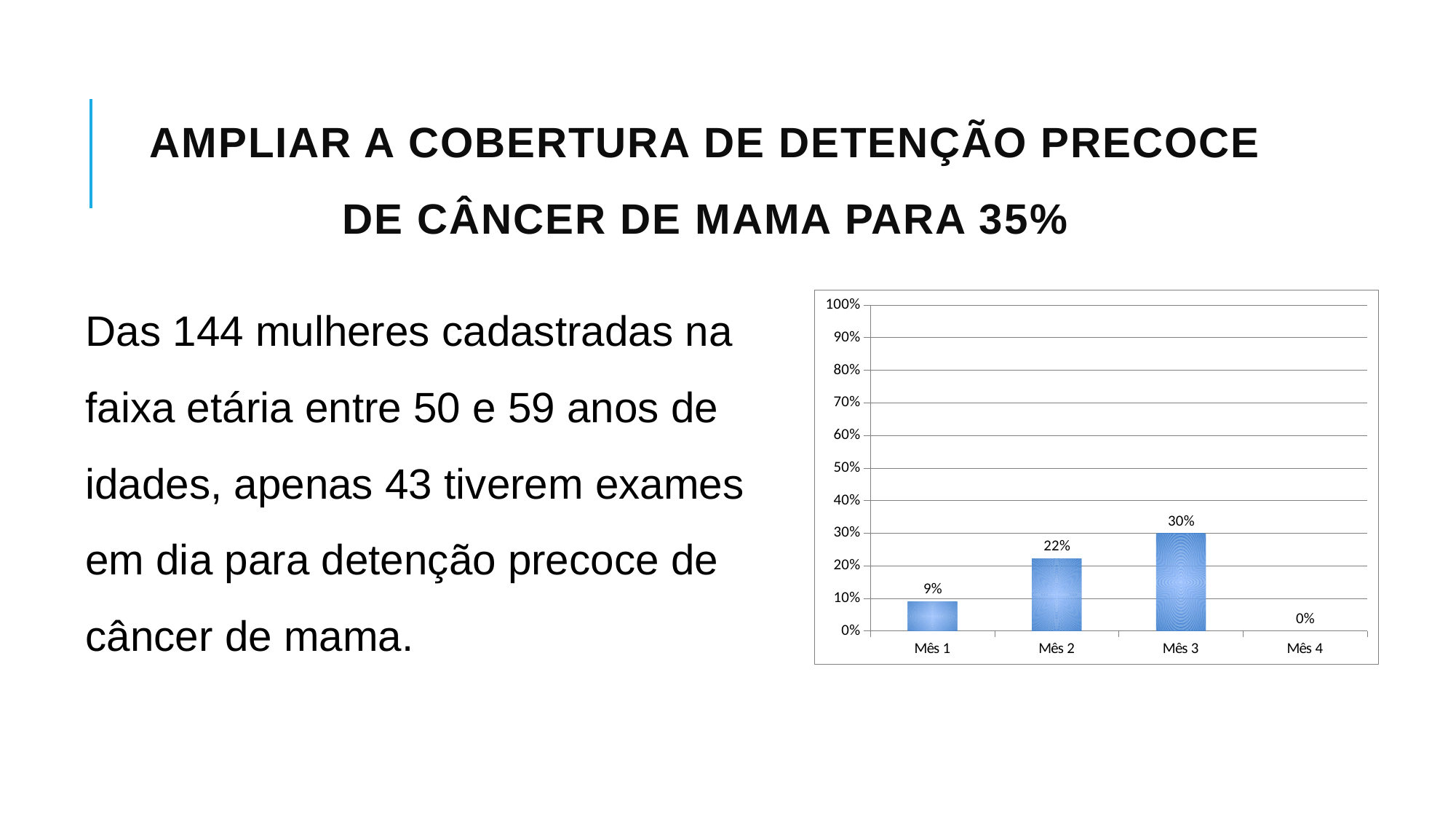
What is the difference between the values for Mês 3 and Mês 1? 21% What is the value for Mês 3? 30% Which month has the highest value? Mês 3 How many months are shown on the x axis? 4 What is the value for Mês 1? 9% What is the difference between the values for Mês 2 and Mês 1? 13% Is the value for Mês 3 greater or less than 20%? greater What kind of chart is shown on the slide? bar chart Which month has the lowest value? Mês 4 What is the value for Mês 2? 22% What is the value for Mês 4? 0% Which is larger, the value for Mês 2 or the value for Mês 3? Mês 3